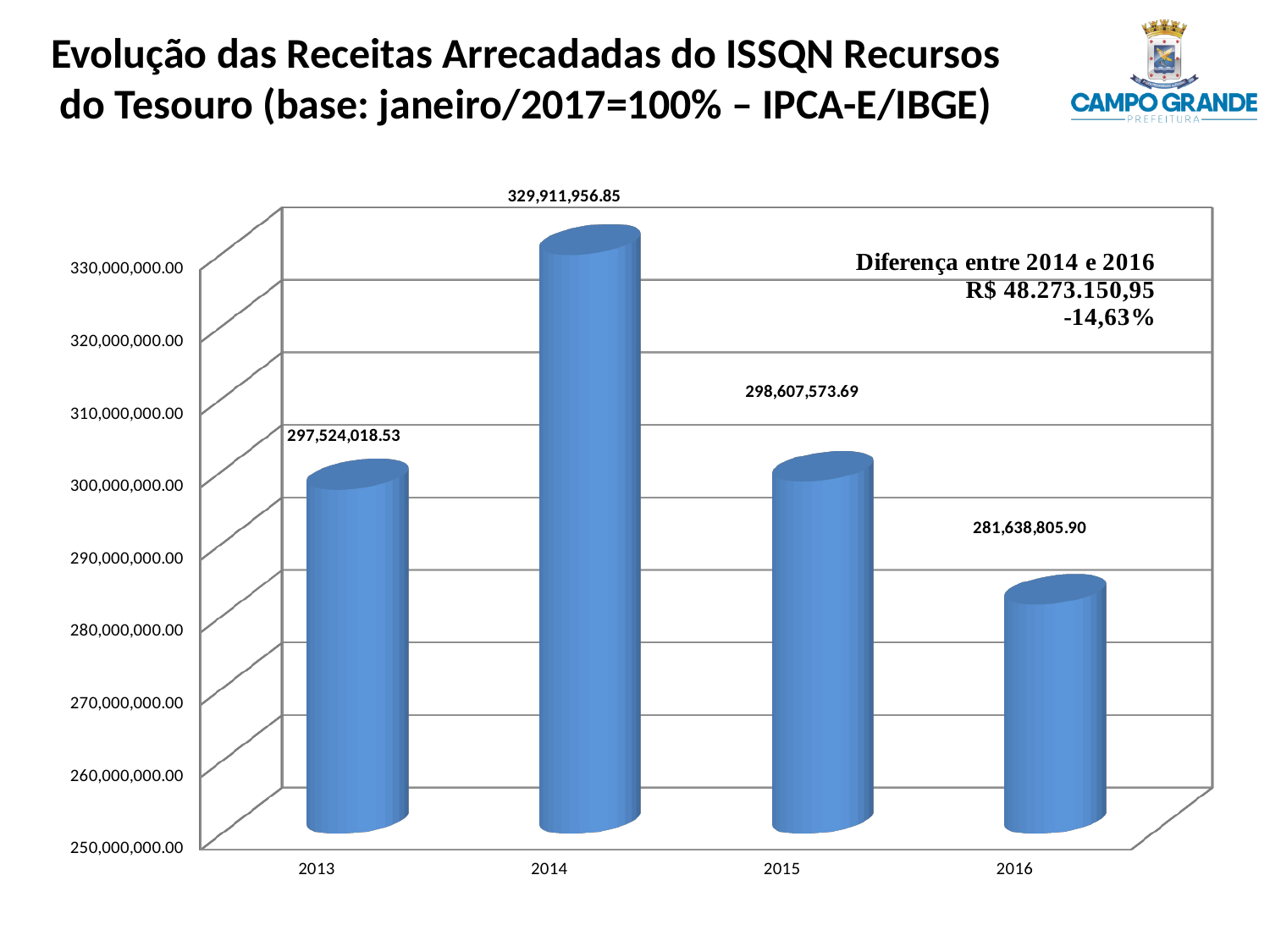
What is the difference between the values for 2014 and 2016? 48,273,150.95 Is the value for 2016 greater or less than 290,000,000.00? less What is the value for 2015? 298,607,573.69 What is the difference between the values for 2014 and 2013? 32,387,938.32 What is the value for 2016? 281,638,805.90 Which is larger, the value for 2014 or the value for 2015? 2014 Which year has the highest value? 2014 How many years are shown on the x axis? 4 What is the value for 2014? 329,911,956.85 What is the value for 2013? 297,524,018.53 Which year has the lowest value? 2016 What kind of chart is shown on the slide? bar chart